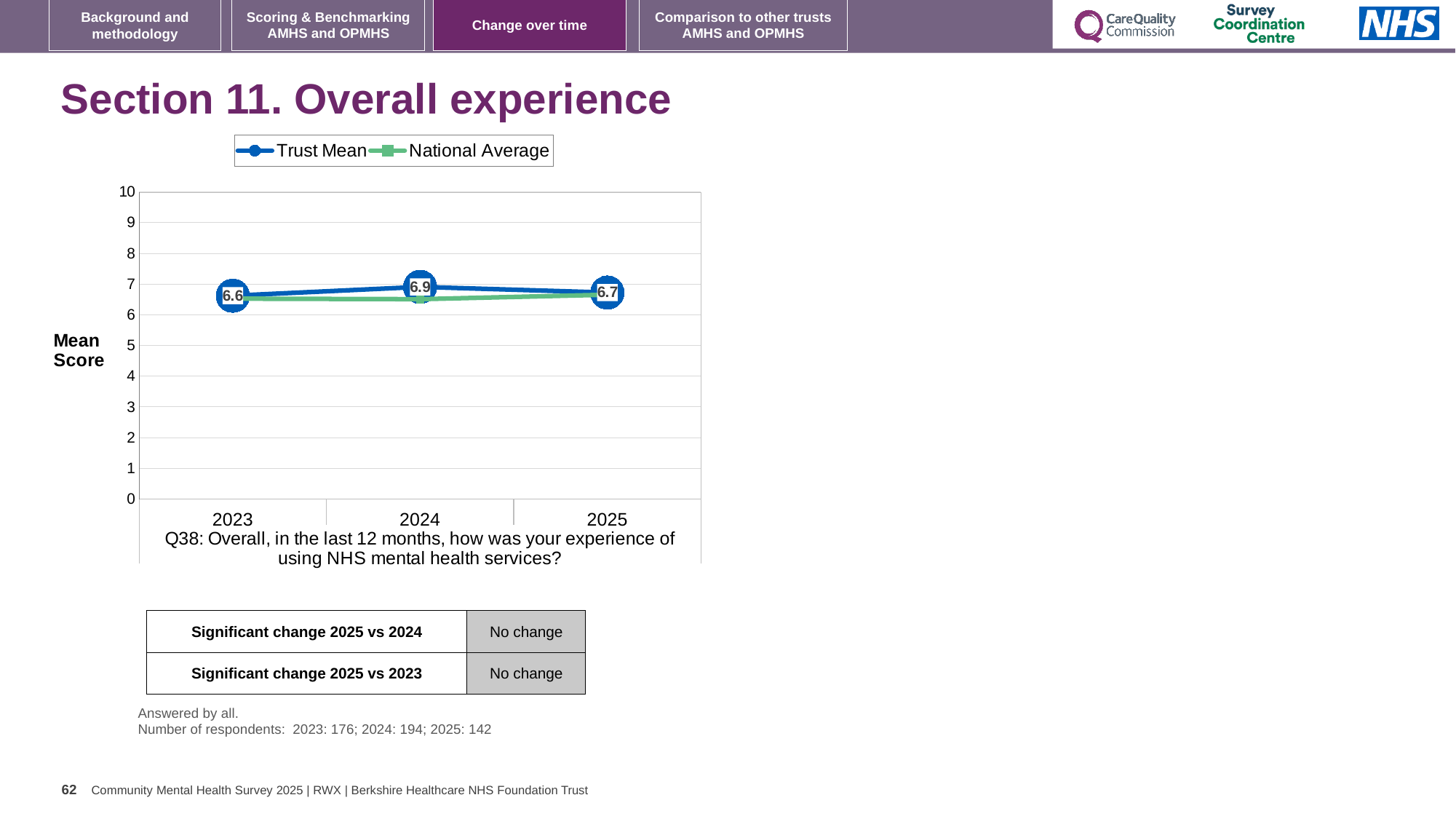
How many years are shown on the x axis? 3 What is the difference between the Trust Mean in 2024 and in 2025? 0.2 What is the Trust Mean score for 2024? 6.9 What is the Trust Mean score for 2025? 6.7 What is the difference between the Trust Mean in 2024 and in 2023? 0.3 What is the Trust Mean score for 2023? 6.6 Is the National Average for 2023 greater or less than 6? greater In which year is the Trust Mean highest? 2024 In which year is the Trust Mean lowest? 2023 Is the National Average for 2024 greater or less than 7? less How many series does the legend list? 2 What kind of chart is shown on the slide? Line chart